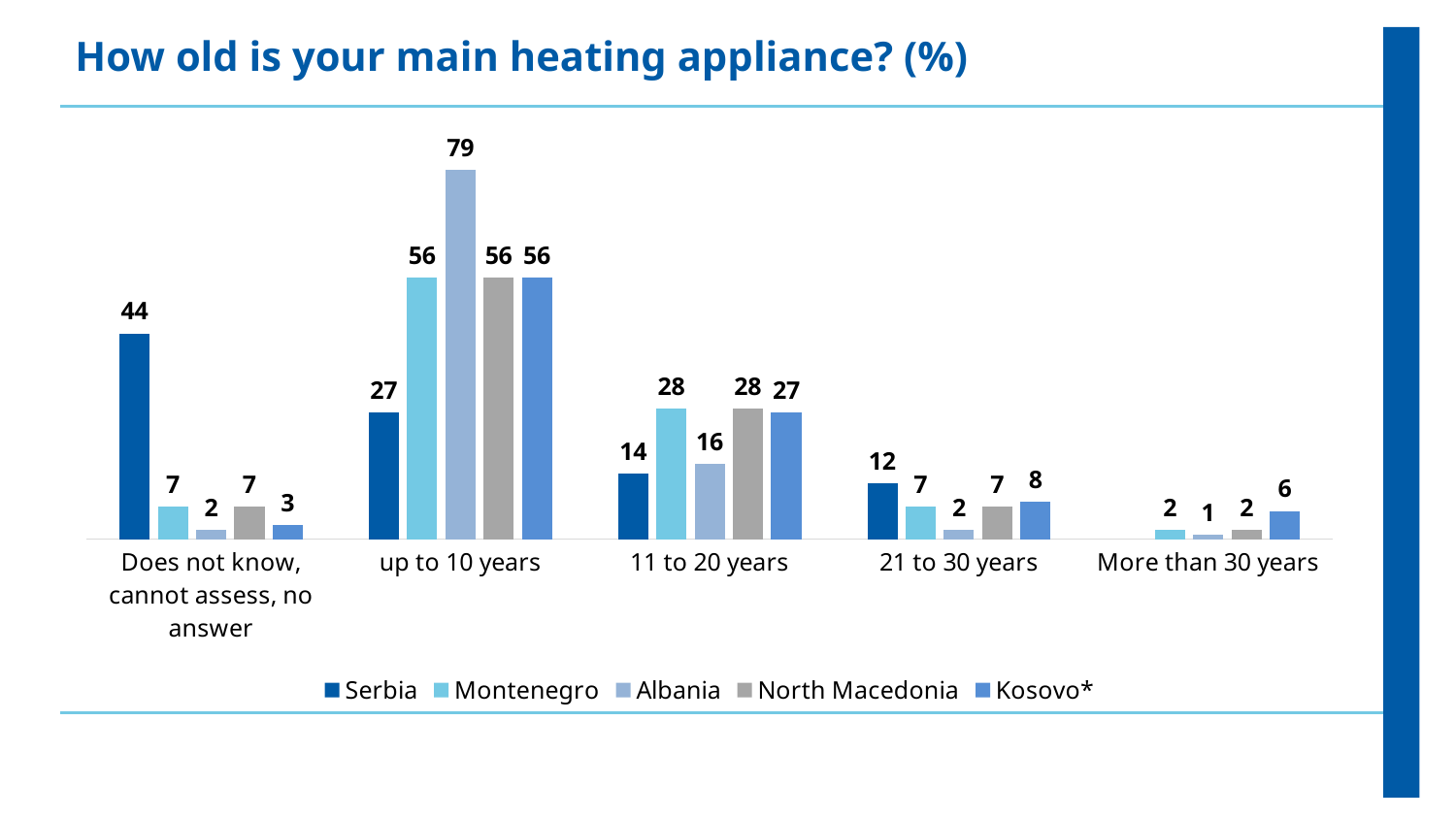
Which country has the lowest value in the 'More than 30 years' category? Albania What is the title of the chart? How old is your main heating appliance? (%) What is the value for Kosovo* in the '11 to 20 years' category? 27 Which country has the highest value in the 'up to 10 years' category? Albania What kind of chart is shown on the slide? Bar chart In the '11 to 20 years' category, which is larger: the value for Montenegro or the value for Albania? Montenegro What is the value for North Macedonia in the '21 to 30 years' category? 7 What is the value for Albania in the 'up to 10 years' category? 79 What is the difference between Albania's and Serbia's values in the 'up to 10 years' category? 52 How many series does the legend list? 5 What is the value for Serbia in the 'Does not know, cannot assess, no answer' category? 44 How many age categories are shown on the x axis? 5